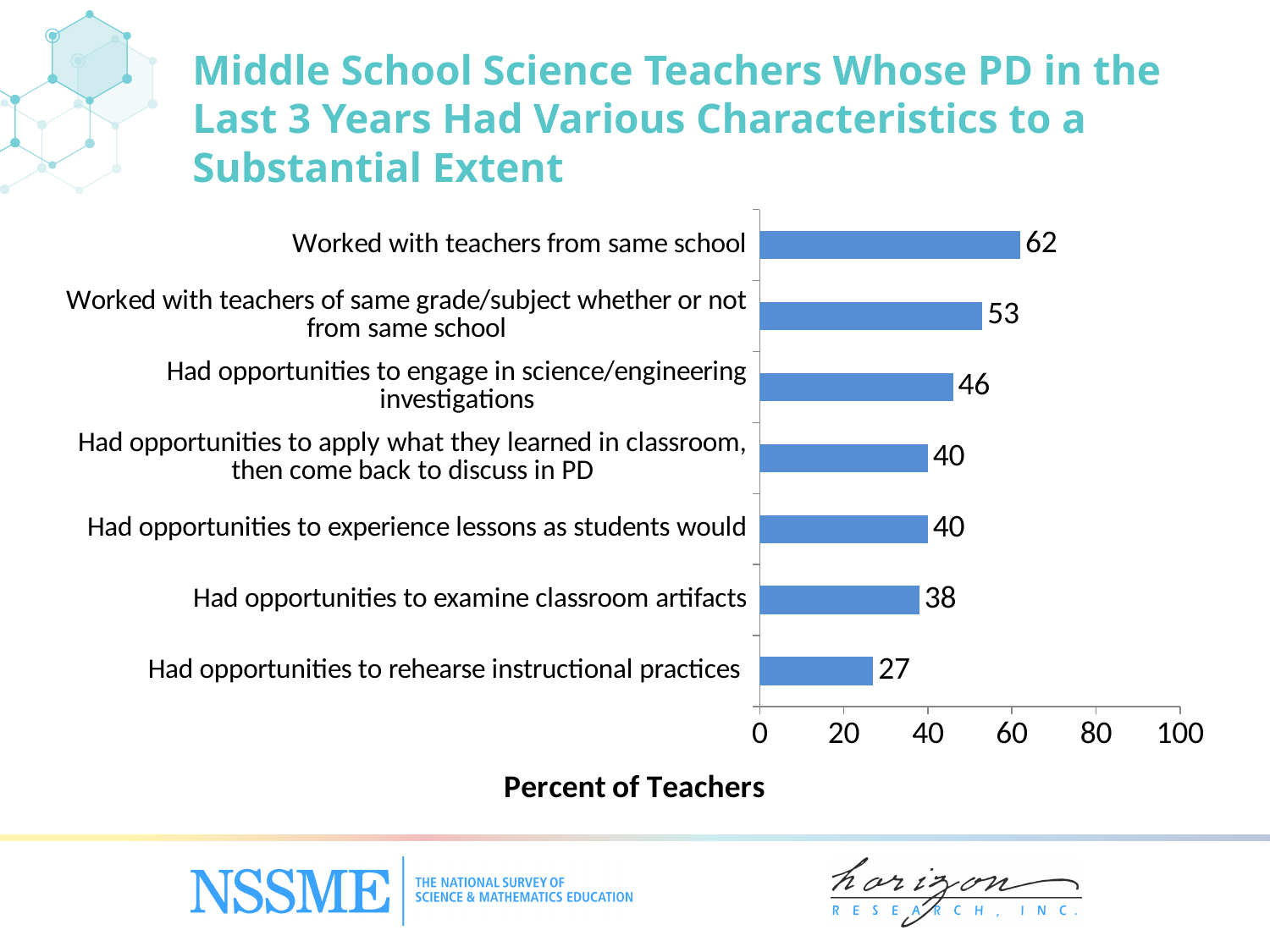
What percent of teachers had opportunities to engage in science/engineering investigations? 46 What percent of teachers had opportunities to experience lessons as students would? 40 What percent of teachers had opportunities to rehearse instructional practices? 27 Which PD characteristic has the lowest percent of teachers? Had opportunities to rehearse instructional practices What percent of middle school science teachers worked with teachers from the same school? 62 What kind of chart is shown on the slide? Bar chart Is the value for 'Had opportunities to examine classroom artifacts' greater or less than 40? less What is the label of the horizontal axis? Percent of Teachers Which PD characteristic has the highest percent of teachers? Worked with teachers from same school What is the difference in percent between 'Worked with teachers from same school' and 'Had opportunities to rehearse instructional practices'? 35 How many PD characteristics are shown in the chart? 7 Which is larger: the percent for 'Worked with teachers of same grade/subject whether or not from same school' or for 'Had opportunities to examine classroom artifacts'? Worked with teachers of same grade/subject whether or not from same school